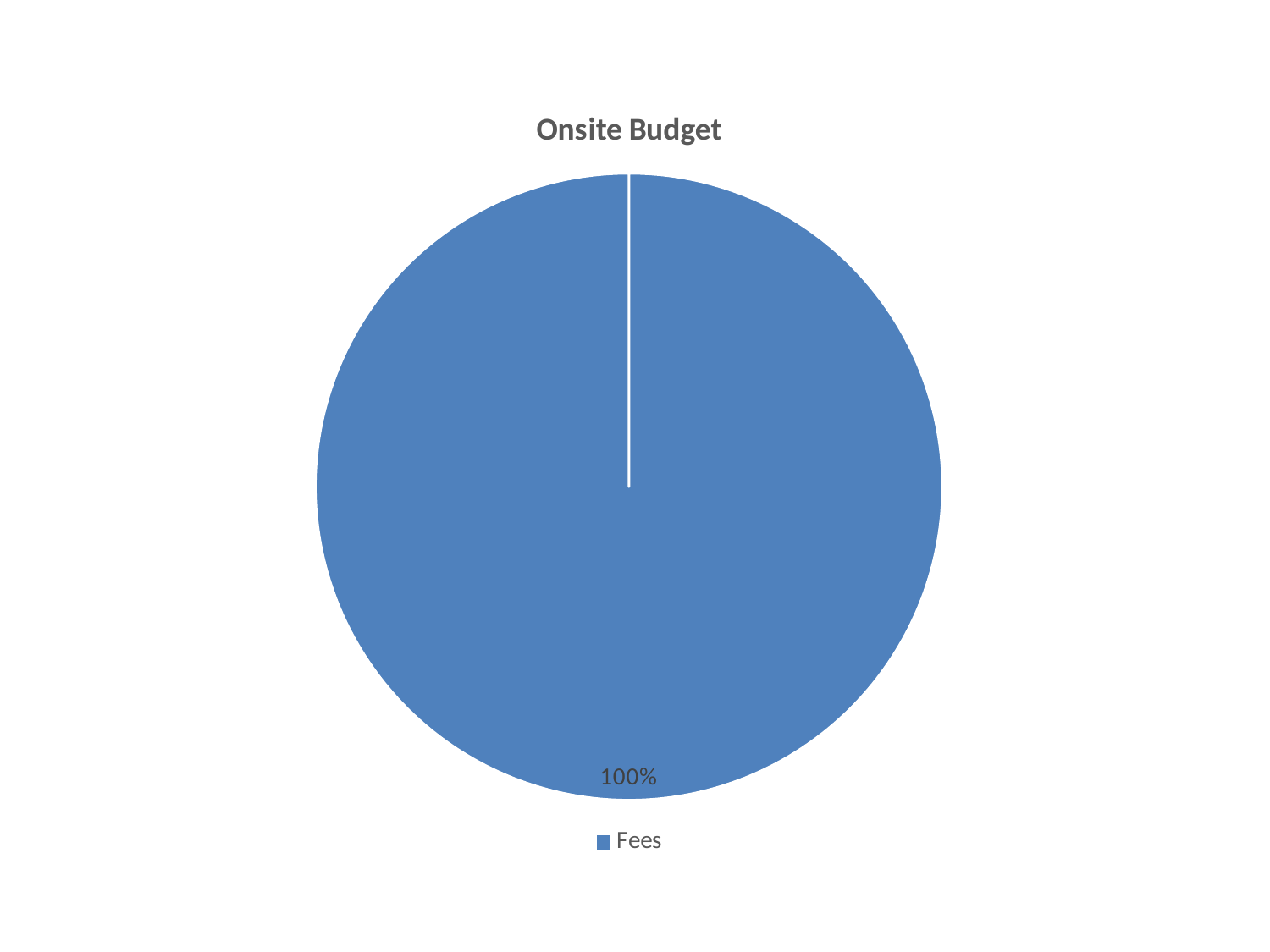
What is the data label shown on the Fees slice? 100% How many slices does the pie chart have? 1 What is the only category listed in the legend? Fees What is the title of the chart? Onsite Budget Which category is the largest slice of the pie? Fees What kind of chart is shown on the slide? pie chart How many entries does the legend list? 1 What share of the pie does Fees account for? 100%